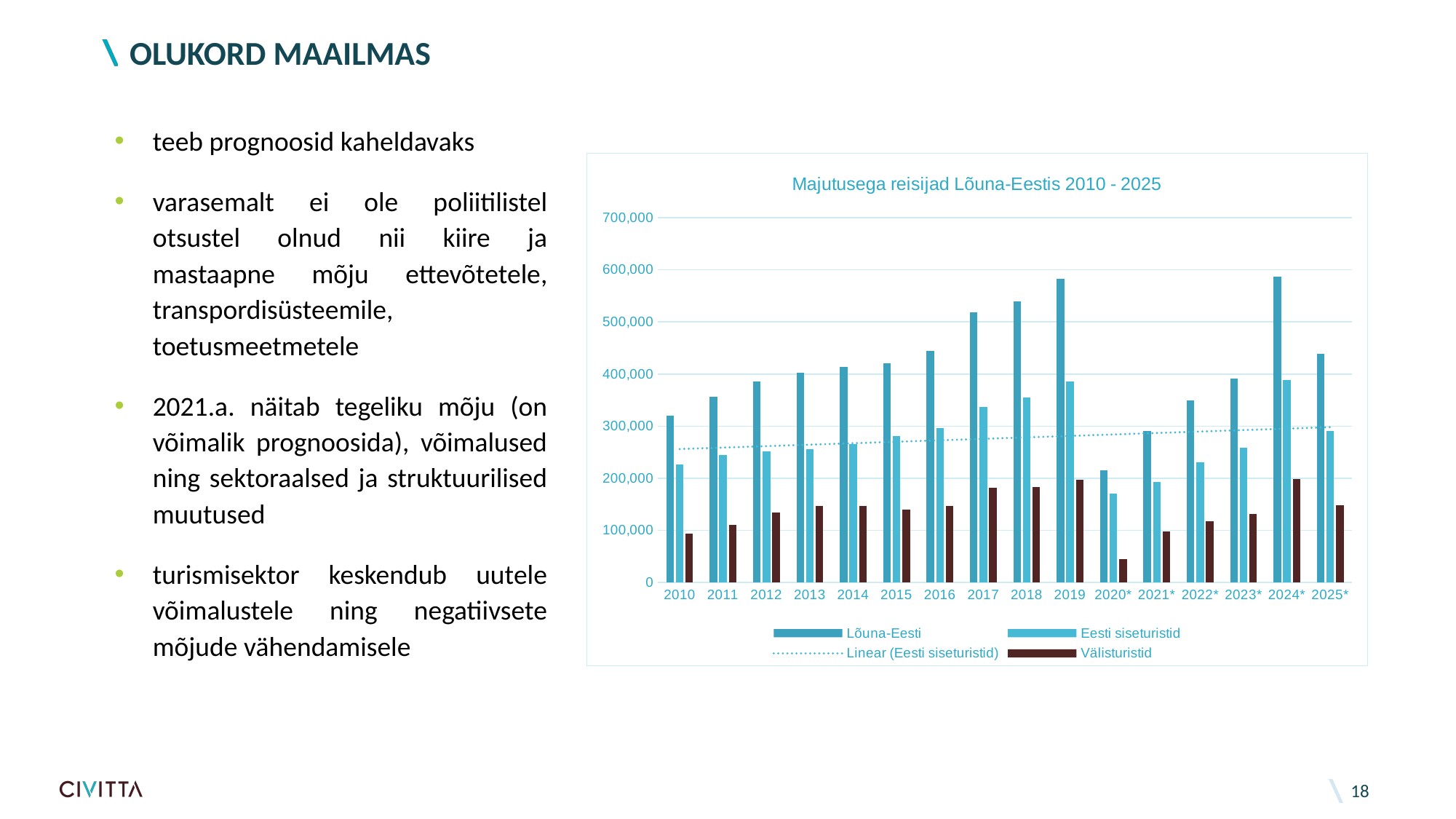
How many years are shown on the x axis of the chart? 16 What is the title of the chart? Majutusega reisijad Lõuna-Eestis 2010 - 2025 Is the Eesti siseturistid value for 2019 greater or less than 400,000? less Which year has the lowest Eesti siseturistid value? 2020* Is the Lõuna-Eesti value for 2019 greater or less than 500,000? greater Which year has the lowest Lõuna-Eesti value? 2020* What kind of chart is shown on the slide? bar chart Which is larger, the Lõuna-Eesti value for 2017 or for 2018? 2018 Which year has the lowest Välisturistid value? 2020* Do the Lõuna-Eesti values rise or fall from 2010 to 2019? rise How many entries does the chart legend list? 4 Is the Välisturistid value for 2020* greater or less than 100,000? less